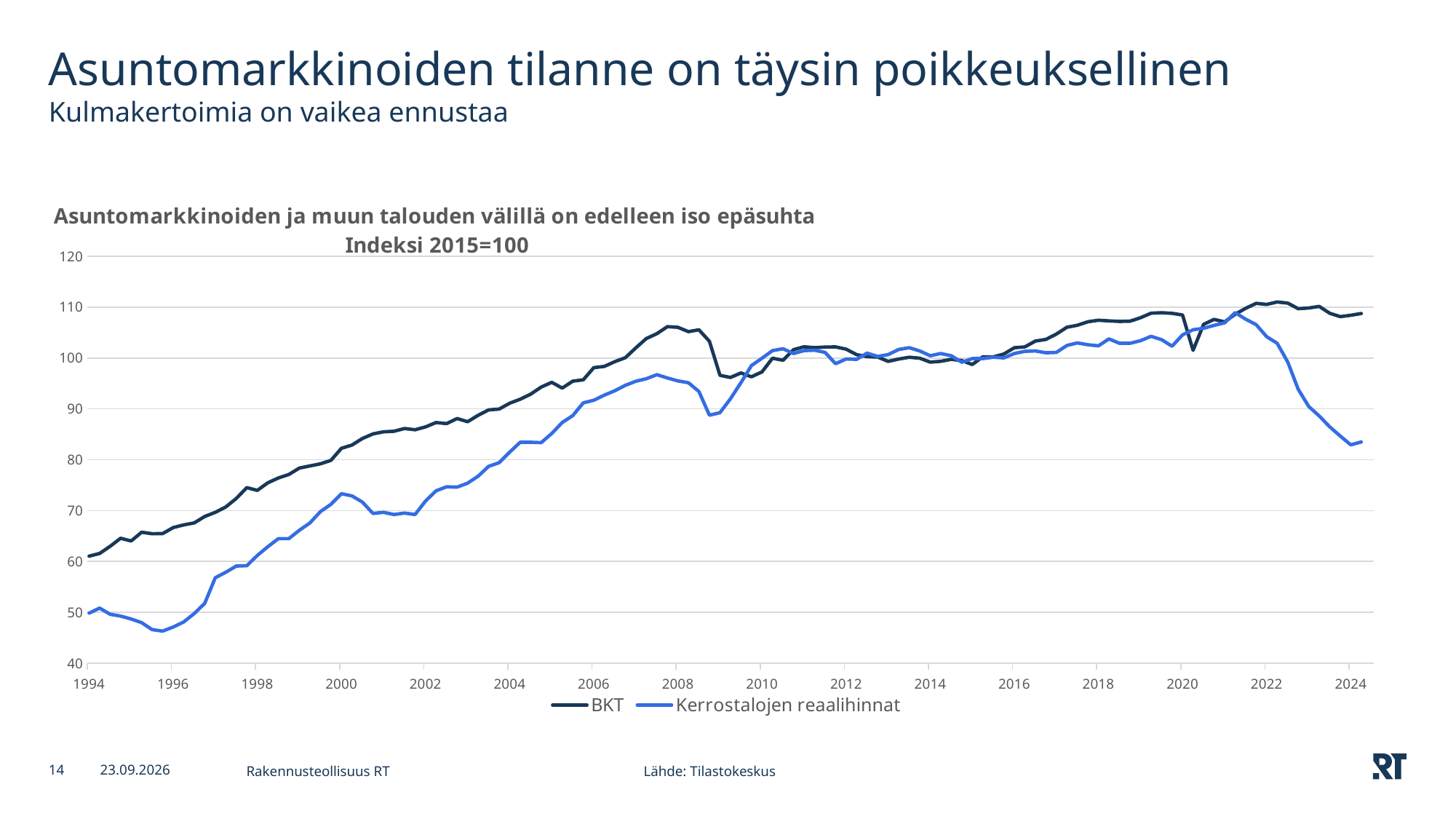
Is the value of Kerrostalojen reaalihinnat in 2024 greater or less than 90? less How many series does the chart's legend list? 2 What is the title of the chart? Asuntomarkkinoiden ja muun talouden välillä on edelleen iso epäsuhta Does the BKT series rise or fall between 1994 and 2008? rise Is the value of BKT in 1994 greater or less than 70? less Which series has the higher value in 2024, BKT or Kerrostalojen reaalihinnat? BKT Is the value of BKT in 2024 greater or less than 100? greater Does the Kerrostalojen reaalihinnat series rise or fall between 2022 and 2024? fall What are the two series named in the chart's legend? BKT and Kerrostalojen reaalihinnat What kind of chart is shown on the slide? line chart